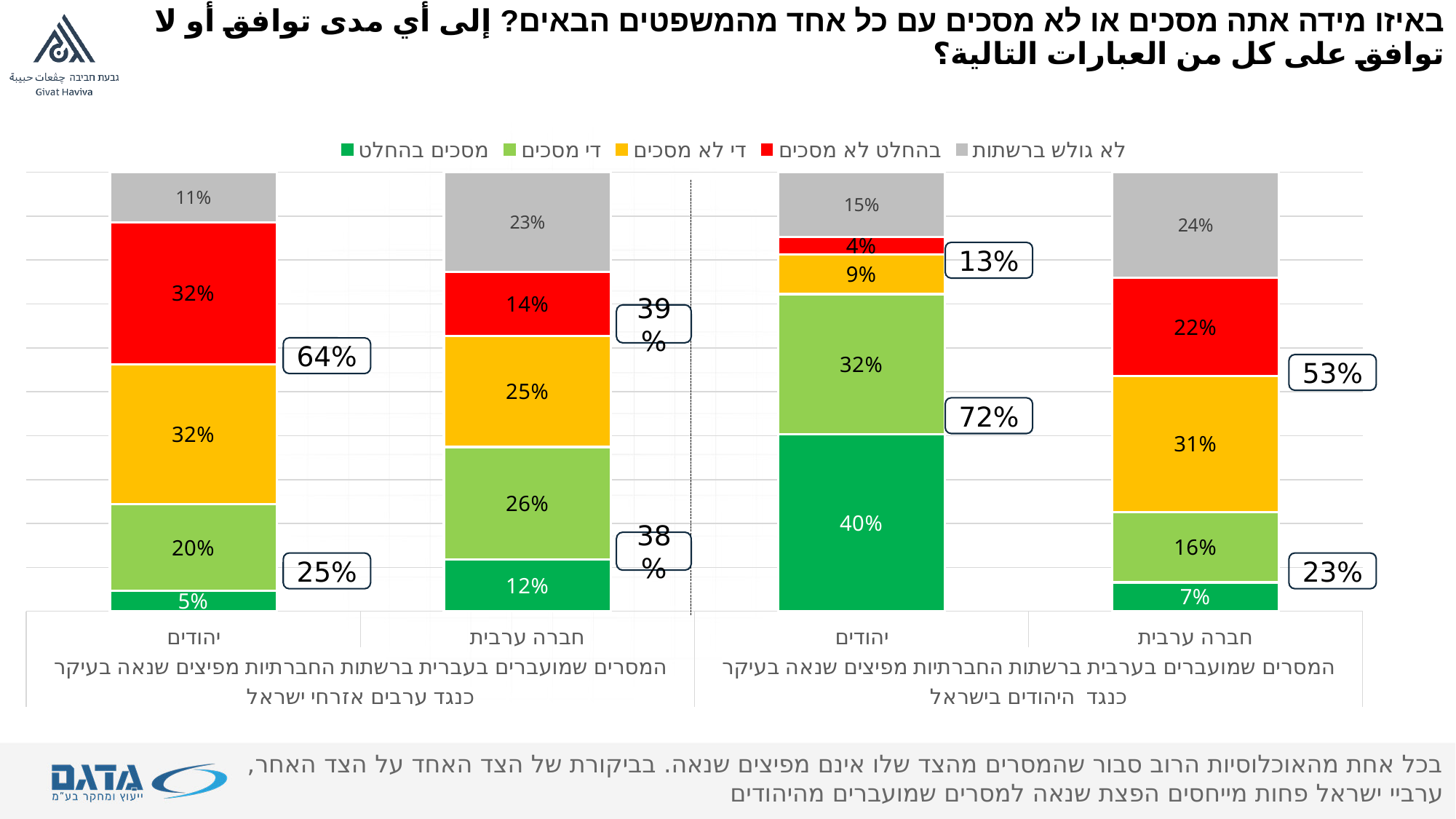
In the left group (messages in Hebrew spread hate against Arab citizens of Israel), what is the value of 'בהחלט לא מסכים' for 'יהודים'? 32% In the left group (messages in Hebrew), what is the value of 'מסכים בהחלט' for 'חברה ערבית'? 12% Across all four bars, which bar has the lowest 'מסכים בהחלט' value? יהודים in the left group (messages in Hebrew) What type of chart is shown on the slide? stacked bar chart Across all four bars, which bar has the highest 'מסכים בהחלט' value? יהודים in the right group (messages in Arabic) In the right group (messages in Arabic), what is the difference between the 'די לא מסכים' values for 'חברה ערבית' and 'יהודים'? 22% How many bars are plotted in the chart? 4 What colour represents 'לא גולש ברשתות' in the legend? grey In the left group (messages in Hebrew), which is larger: 'די מסכים' for 'יהודים' or 'די מסכים' for 'חברה ערבית'? חברה ערבית In the right group (messages in Arabic spread hate against Jews in Israel), what is the value of 'מסכים בהחלט' for 'יהודים'? 40% How many series does the legend list? 5 In the right group (messages in Arabic), what is the value of 'לא גולש ברשתות' for 'חברה ערבית'? 24%